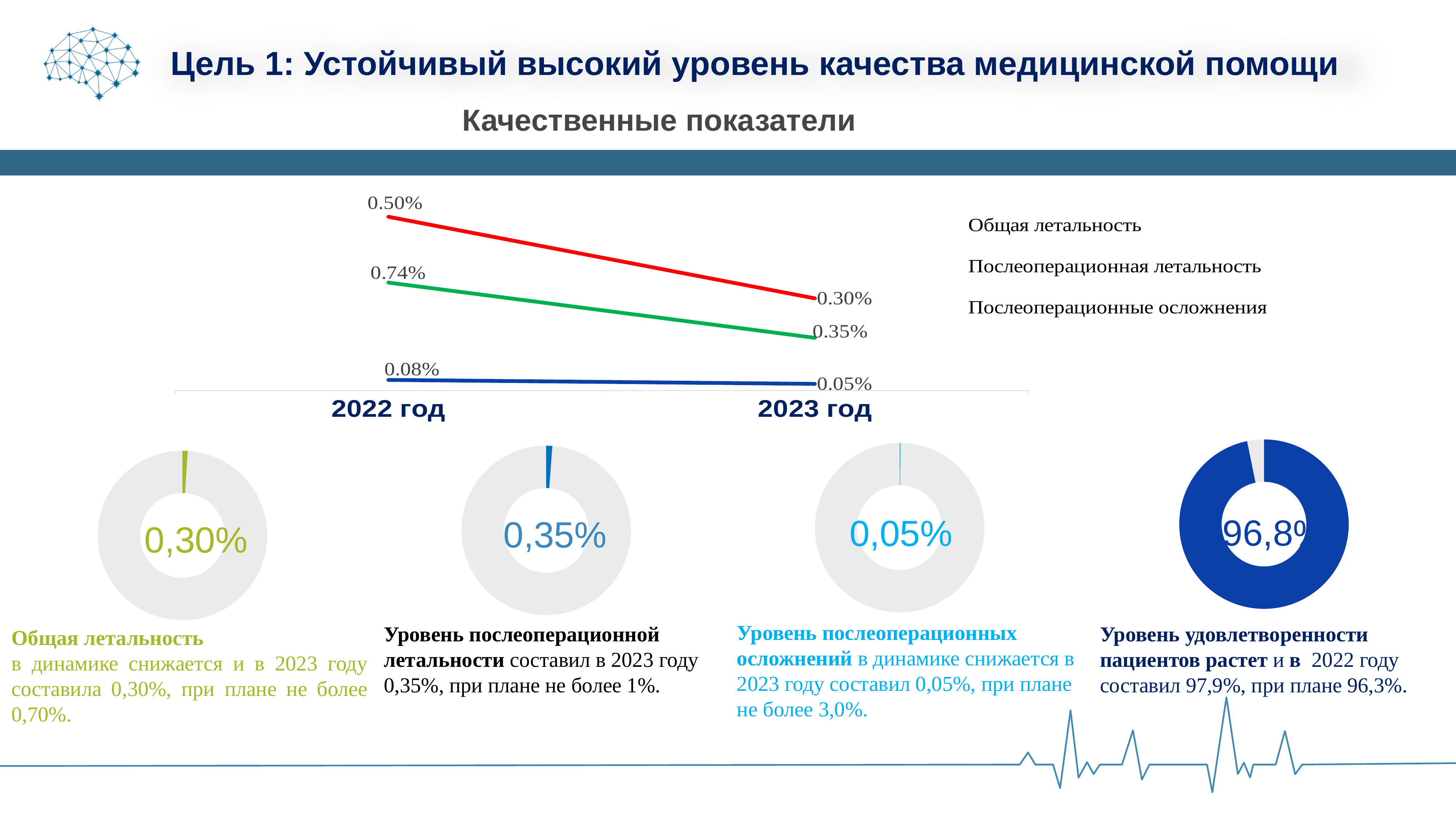
In the line chart, do the values rise or fall from 2022 год to 2023 год? fall In the line chart, what is the value of the red line for 2022 год? 0.50% What type of chart is the chart at the top of the slide with the years 2022 год and 2023 год? line chart In the line chart, what is the value of the blue line for 2022 год? 0.08% In the line chart, by how much did the red line decrease from 2022 год to 2023 год? 0.20% In the line chart, what is the value of the green line for 2023 год? 0.35% What value is shown in the centre of the rightmost donut chart (Уровень удовлетворенности пациентов)? 96,8% In the line chart, which line has the lowest value in 2023 год? the blue line (Послеоперационные осложнения) What value is shown in the centre of the leftmost donut chart (Общая летальность)? 0,30% In the line chart, which line has the highest value in 2022 год? the green line (Послеоперационная летальность) How many series does the legend of the line chart list? 3 In the line chart, what is the value of the blue line for 2023 год? 0.05%